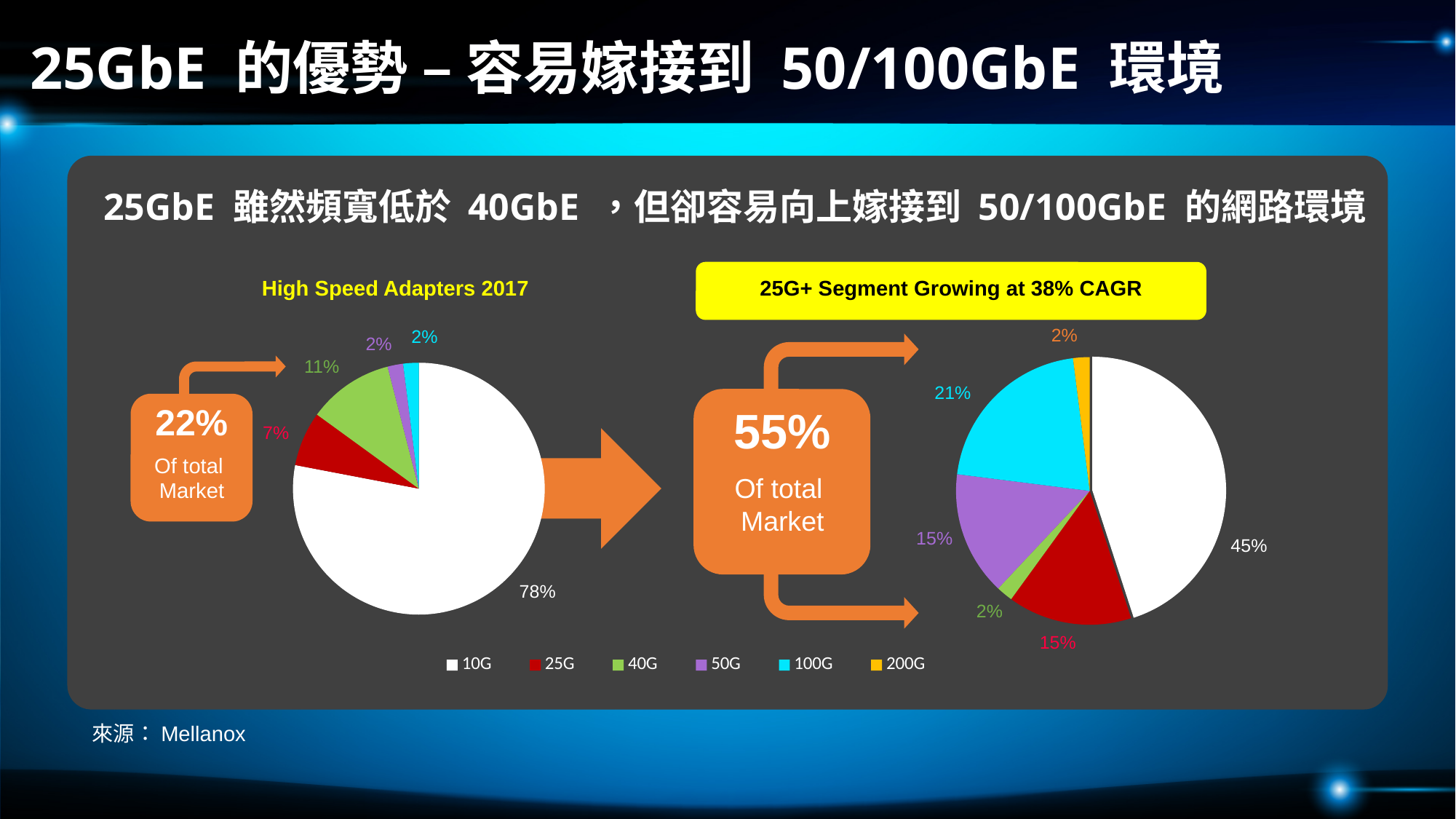
In the left pie chart titled 'High Speed Adapters 2017', what is the difference between the 40G share and the 25G share? 4% How many entries does the legend list? 6 In the left pie chart titled 'High Speed Adapters 2017', what share does 40G have? 11% What type of charts are shown on the slide? Pie charts In the left pie chart titled 'High Speed Adapters 2017', what share does 25G have? 7% In the right pie chart, what share does 100G have? 21% In the right pie chart, what share does 200G have? 2% In the left pie chart titled 'High Speed Adapters 2017', what share does 10G have? 78% In the right pie chart, which is larger, the 100G share or the 50G share? 100G In the left pie chart titled 'High Speed Adapters 2017', which segment has the largest share? 10G In the right pie chart, what share does 10G have? 45% What is the title of the left pie chart? High Speed Adapters 2017